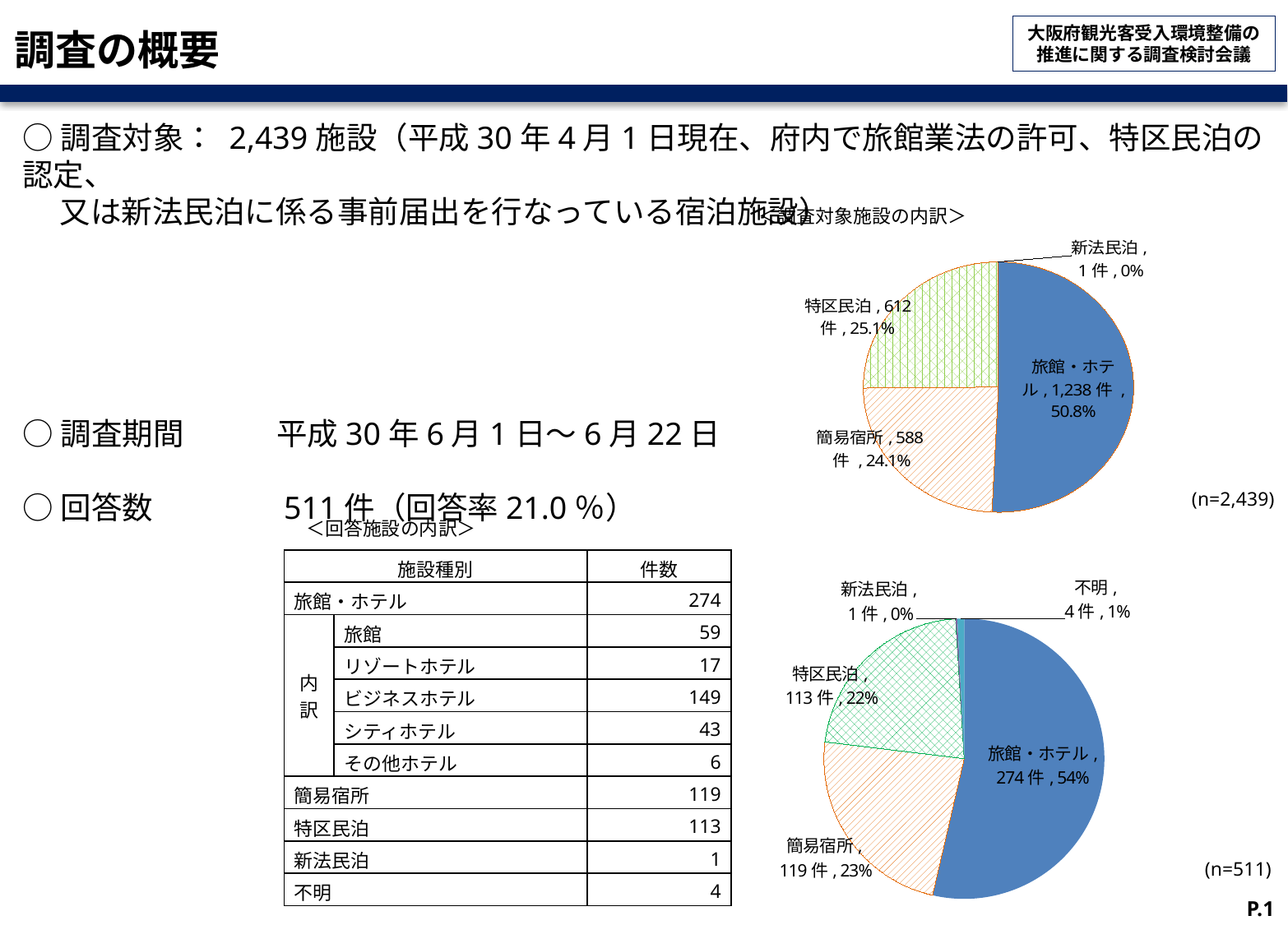
In the top pie chart (n=2,439), what share does 特区民泊 hold? 25.1% What kind of chart is the top chart on the right (調査対象施設の内訳)? pie chart In the top pie chart (n=2,439), how many facilities are in the 旅館・ホテル slice? 1,238 件 In the bottom pie chart (n=511), how many facilities are in the 簡易宿所 slice? 119 件 In the top pie chart (n=2,439), which category has the largest slice? 旅館・ホテル In the bottom pie chart (n=511), what share does 旅館・ホテル hold? 54% How many slices does the top pie chart (n=2,439) have? 4 In the bottom pie chart (n=511), which is larger, 簡易宿所 or 特区民泊? 簡易宿所 How many slices does the bottom pie chart (n=511) have? 5 In the top pie chart (n=2,439), which category has the smallest slice? 新法民泊 In the top pie chart (n=2,439), what is the difference in count between 特区民泊 and 簡易宿所? 24 件 In the bottom pie chart (n=511), what is the difference in count between 旅館・ホテル and 特区民泊? 161 件